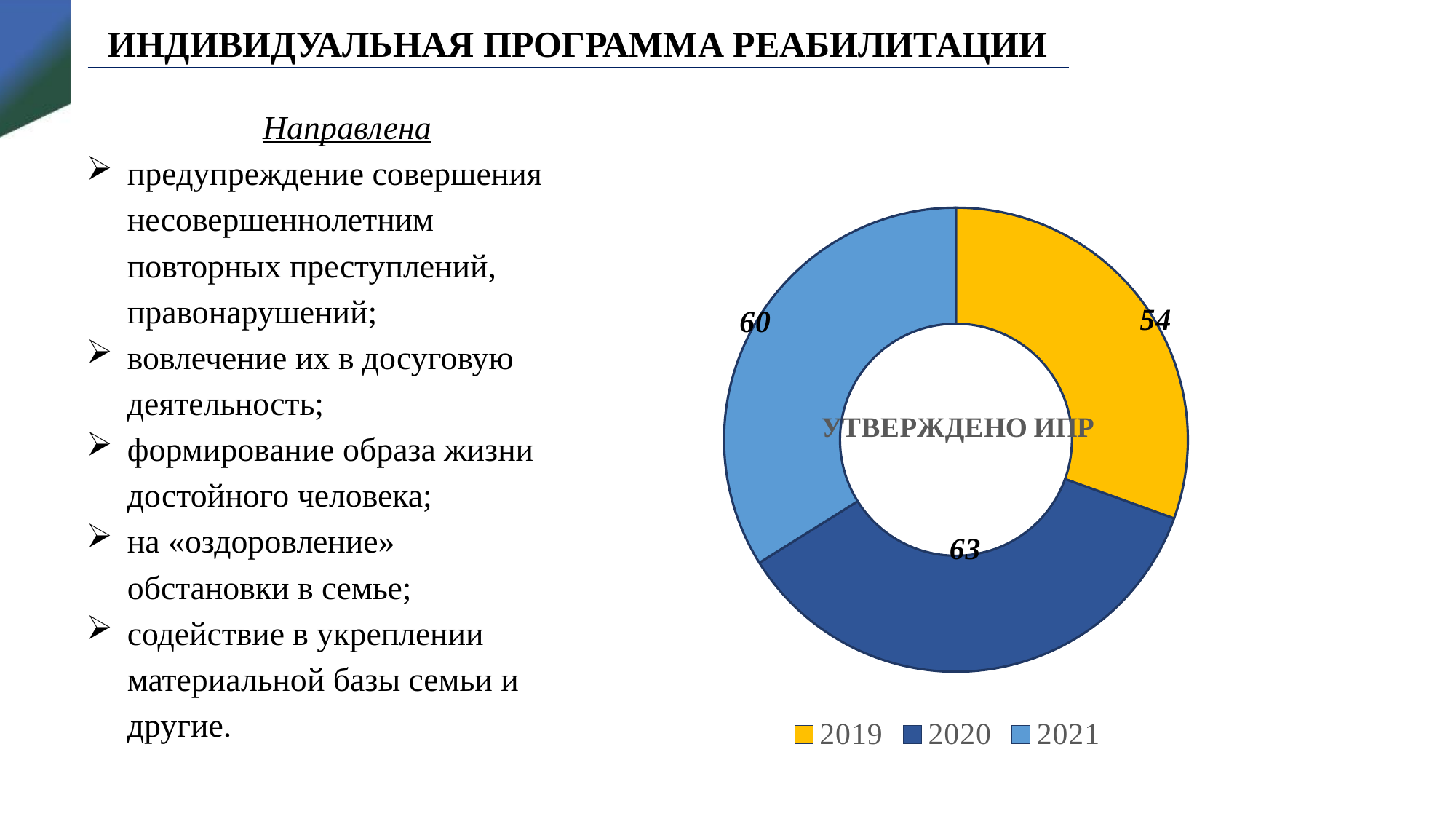
What text is shown in the centre of the doughnut chart? УТВЕРЖДЕНО ИПР Which is larger, the value for 2021 or the value for 2019? 2021 How many entries does the legend list? 3 What value is shown for 2019 in the doughnut chart? 54 What is the difference between the values for 2021 and 2019? 6 What value is shown for 2020 in the doughnut chart? 63 What is the difference between the values for 2020 and 2019? 9 Which year has the highest value in the chart? 2020 What value is shown for 2021 in the doughnut chart? 60 What kind of chart is shown on the slide? Doughnut chart How many slices does the chart have? 3 Which year has the lowest value in the chart? 2019